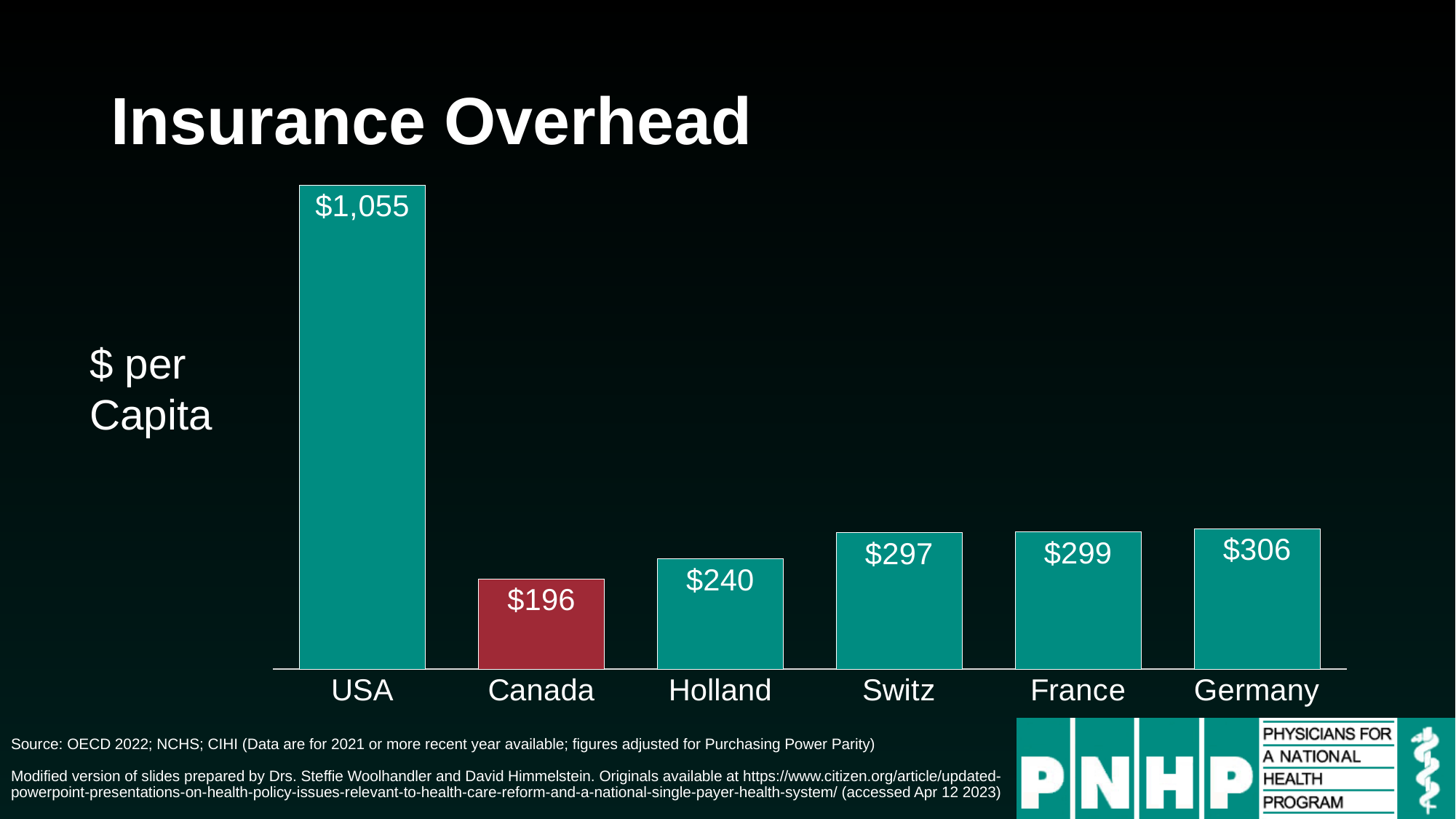
What kind of chart is shown on the slide? Bar chart What is the difference in insurance overhead per capita between Germany and Holland? $66 What is the insurance overhead per capita for Canada? $196 What is the insurance overhead per capita for Germany? $306 Which country has the lowest insurance overhead per capita? Canada Which has a higher insurance overhead per capita, Holland or Switz? Switz What is the insurance overhead per capita for Holland? $240 What is the difference in insurance overhead per capita between the USA and Canada? $859 Which country's bar is coloured red rather than teal? Canada What is the insurance overhead per capita for the USA? $1,055 How many countries are shown in the chart? 6 Which country has the highest insurance overhead per capita? USA